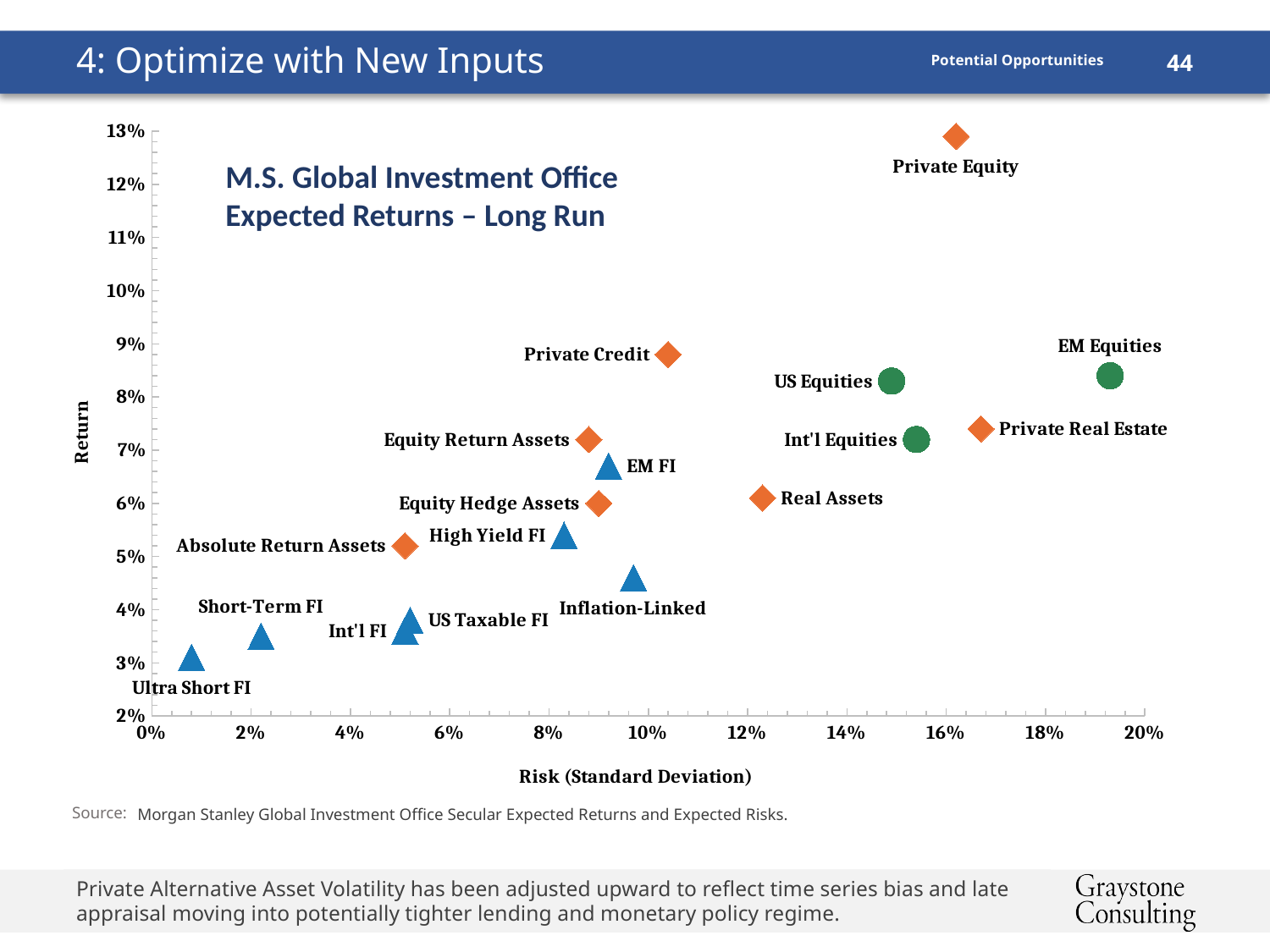
What is the title of the chart? M.S. Global Investment Office Expected Returns – Long Run Is the expected return for Private Equity greater or less than 12%? greater Is the expected return for Inflation-Linked greater or less than 5%? less Which asset class has the lowest expected return? Ultra Short FI Which asset class has the highest expected return? Private Equity How many asset classes are plotted on the chart? 17 Which asset class has the highest risk (standard deviation)? EM Equities Which has the higher risk (standard deviation), Private Equity or EM Equities? EM Equities Which has the higher expected return, Private Credit or US Equities? Private Credit What is the label of the horizontal axis? Risk (Standard Deviation) What kind of chart is shown on the slide? Scatter chart